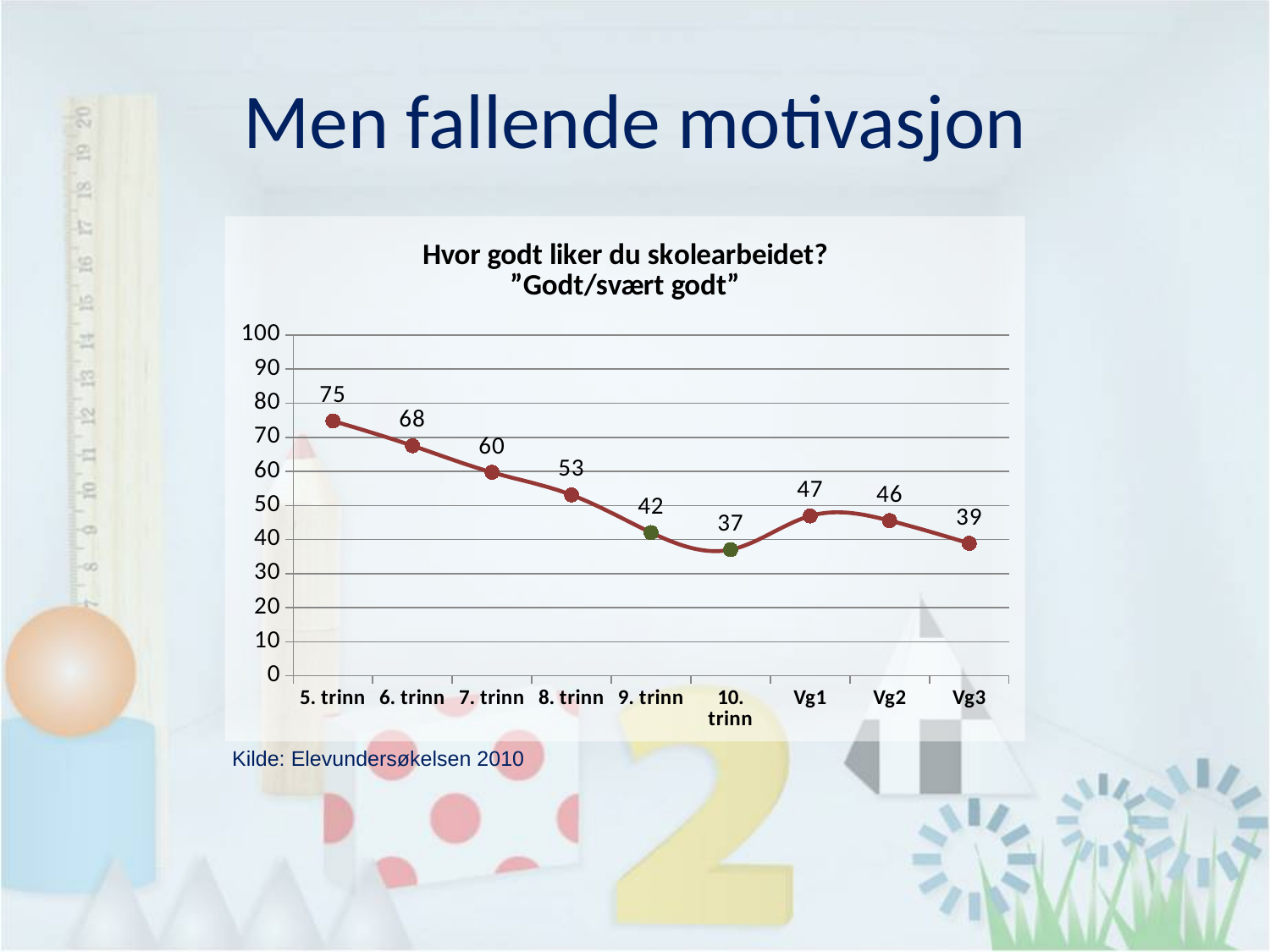
What is the value for 8. trinn? 53 What is the difference between the values for 5. trinn and 10. trinn? 38 What is the value for 5. trinn? 75 What kind of chart is this? line chart What is the value for Vg3? 39 Which category has the highest value? 5. trinn How many categories are shown on the x axis? 9 What is the value for 10. trinn? 37 Which is larger, the value for Vg1 or the value for 9. trinn? Vg1 Do the values generally rise or fall from 5. trinn to Vg3? fall What is the title of the chart? Hvor godt liker du skolearbeidet? "Godt/svært godt" Which category has the lowest value? 10. trinn